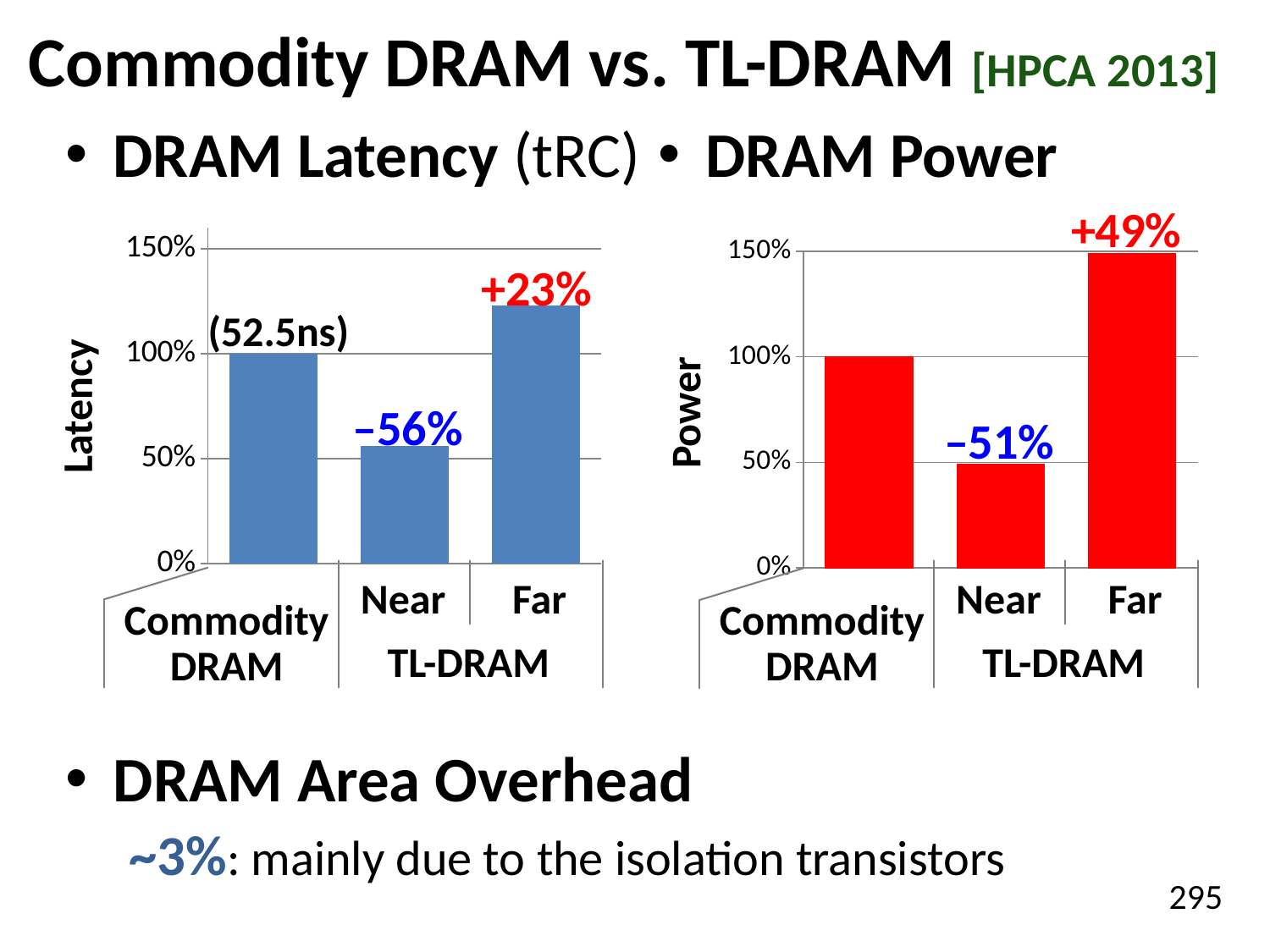
In the DRAM Latency chart, which bar is the lowest? Near How many bars are plotted in the DRAM Power chart? 3 What type of chart is the DRAM Latency chart? bar chart In the DRAM Power chart, what change label is printed above the Near bar? –51% In the DRAM Latency chart, what absolute latency is noted in parentheses for Commodity DRAM? (52.5ns) In the DRAM Power chart, is the value for Far greater or less than 100%? greater In the DRAM Latency chart, what is the value of the Commodity DRAM bar? 100% In the DRAM Latency chart, what change label is printed above the Far bar? +23% In the DRAM Power chart, what change label is printed above the Far bar? +49% In the DRAM Latency chart, what change label is printed above the Near bar? –56% In the DRAM Power chart, which bar is the highest? Far In the DRAM Latency chart, is the value for Near greater or less than 50%? greater